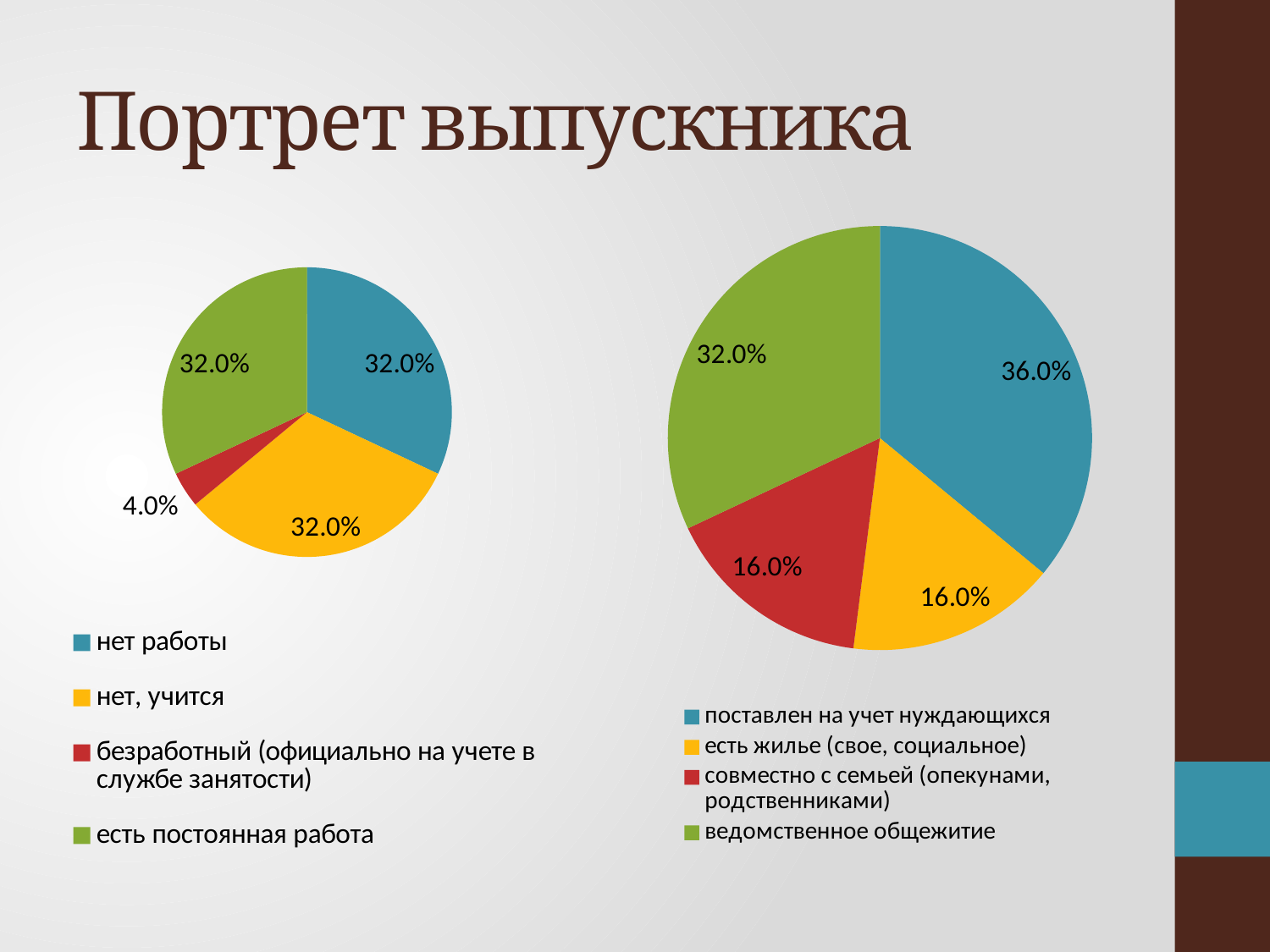
On the right pie chart, what share is labelled for "поставлен на учет нуждающихся"? 36.0% On the left pie chart, which category has the smallest slice? безработный (официально на учете в службе занятости) How many slices does the left pie chart have? 4 On the right pie chart, what is the difference between the shares for "поставлен на учет нуждающихся" and "есть жилье (свое, социальное)"? 20.0% What kind of chart is the chart on the left of the slide? pie chart On the right pie chart, which is larger: the share for "ведомственное общежитие" or the share for "совместно с семьей (опекунами, родственниками)"? ведомственное общежитие On the left pie chart, what share is labelled for "нет работы"? 32.0% On the right pie chart, what share is labelled for "ведомственное общежитие"? 32.0% How many entries does the legend of the right pie chart list? 4 What is the title of the slide? Портрет выпускника On the right pie chart, which category has the largest slice? поставлен на учет нуждающихся On the left pie chart, what share is labelled for "безработный (официально на учете в службе занятости)"? 4.0%